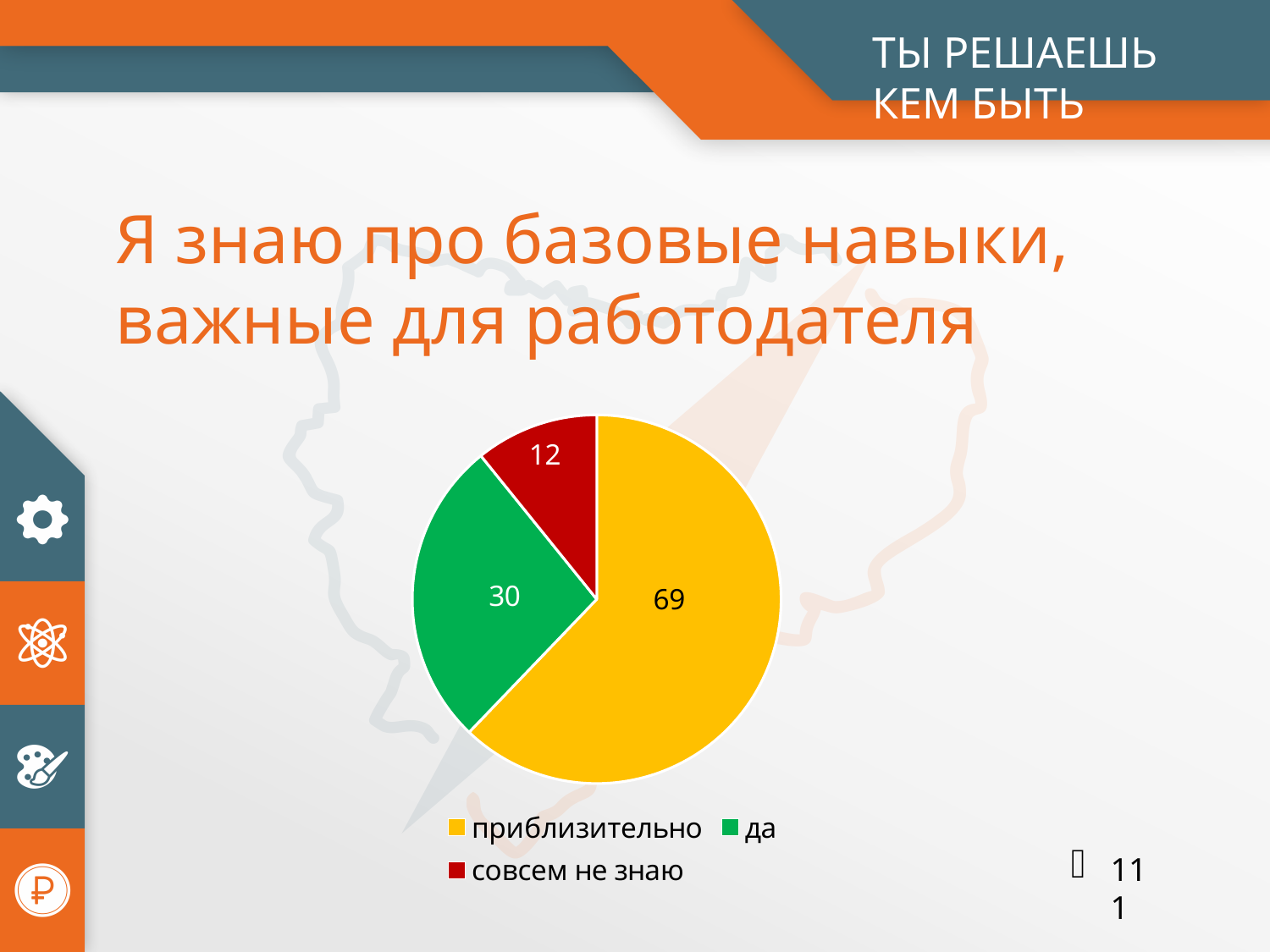
What value is shown for the "да" slice of the pie chart? 30 What value is shown for the "совсем не знаю" slice of the pie chart? 12 What is the difference between the values for "да" and "совсем не знаю"? 18 How many slices does the pie chart have? 3 Which is larger, the value for "да" or the value for "совсем не знаю"? да Which category has the largest slice in the pie chart? приблизительно What is the difference between the values for "приблизительно" and "да"? 39 What colour is the "да" slice in the pie chart? green Which category has the smallest slice in the pie chart? совсем не знаю What value is shown for the "приблизительно" slice of the pie chart? 69 What type of chart is shown on the slide? pie chart What is the total of all the values shown in the pie chart? 111